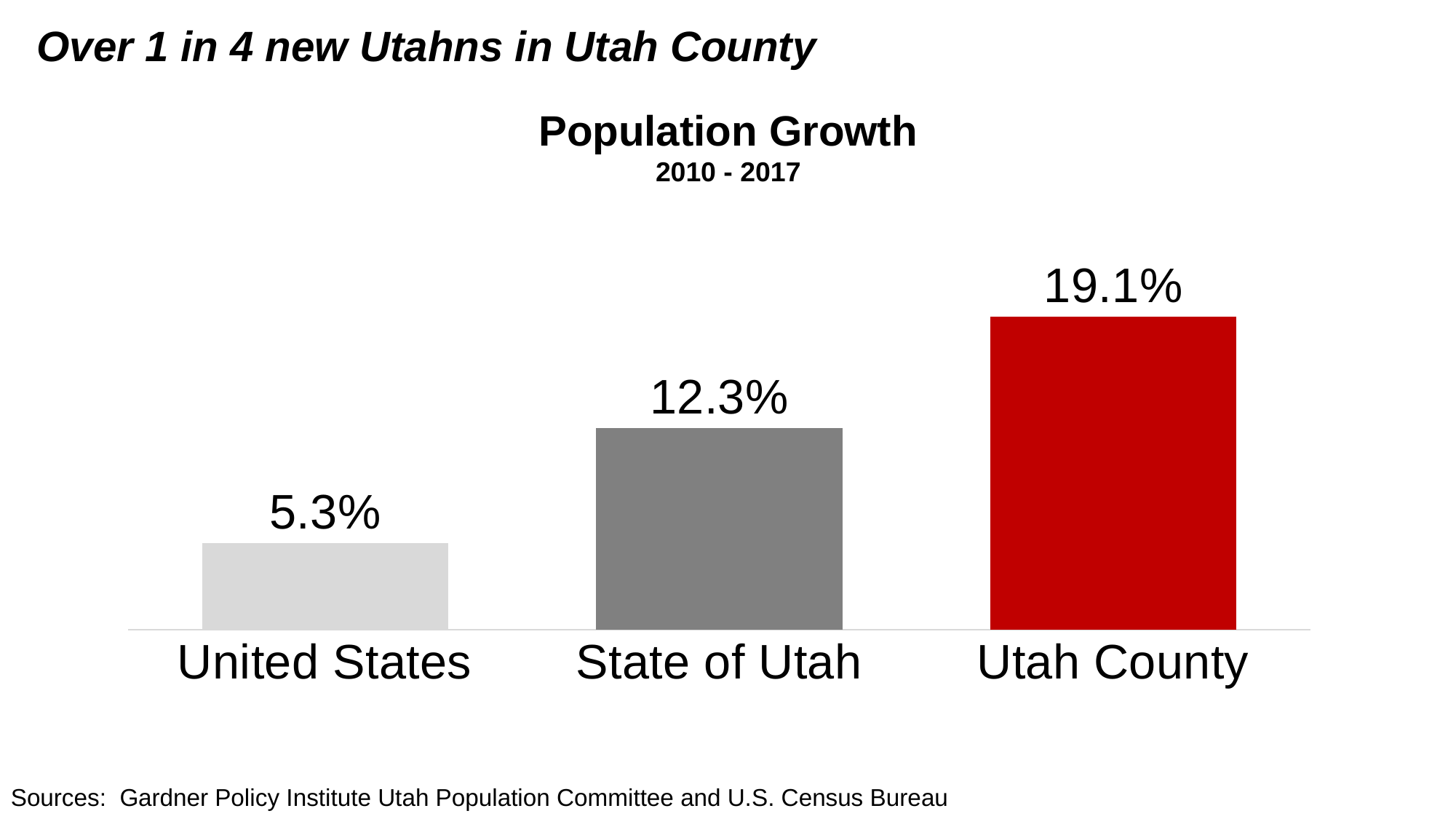
What is the difference in population growth between the State of Utah and the United States? 7.0% What is the population growth value for the United States? 5.3% Do the values rise or fall from left to right across the categories? Rise What time period does the chart subtitle cover? 2010 - 2017 What is the population growth value for Utah County? 19.1% How many categories are shown in the chart? 3 What kind of chart is shown on the slide? Bar chart Which category has the highest population growth? Utah County What is the difference in population growth between Utah County and the State of Utah? 6.8% What is the population growth value for the State of Utah? 12.3% Which has a larger population growth value, the State of Utah or the United States? State of Utah Which category has the lowest population growth? United States